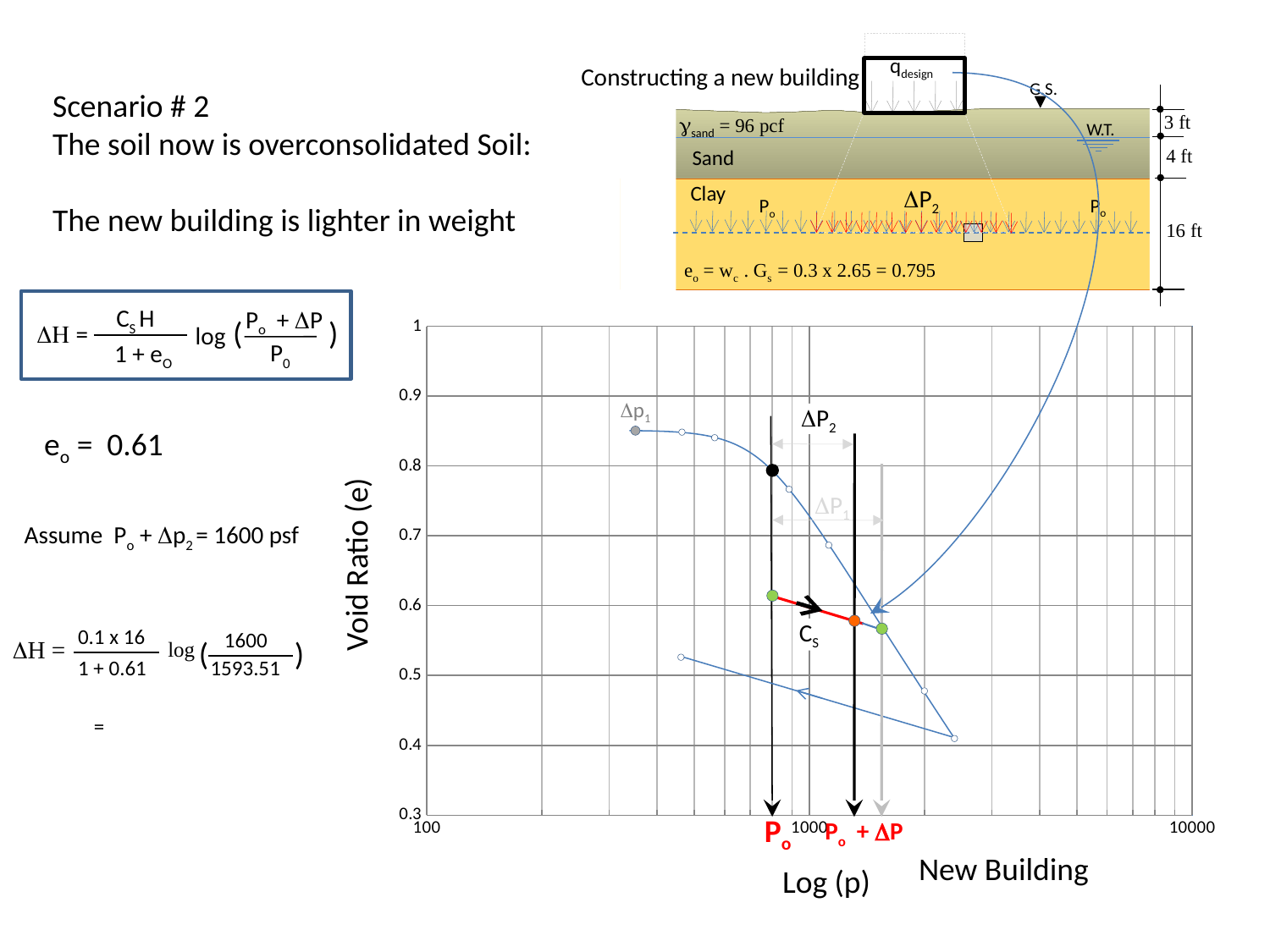
What is the label of the vertical axis of the chart? Void Ratio (e) Along the main curve, does the void ratio rise or fall as the pressure p increases? fall How many tick values are labelled on the vertical axis of the chart? 8 Is the void ratio of the orange point at Po + ΔP greater or less than 0.7? less What is the lowest value shown on the vertical axis of the chart? 0.3 What is the highest value shown on the vertical axis of the chart? 1 Is the void ratio of the black point on the curve at Po greater or less than 0.7? greater Which of the two vertical lines, Po or Po + ΔP, is located further to the right on the horizontal axis? Po + ΔP What is the largest tick value shown on the horizontal axis of the chart? 10000 What is the label of the horizontal axis of the chart? Log (p) Is the void ratio of the grey point labelled Δp1 greater or less than 0.8? greater What kind of chart is shown on the slide? line chart